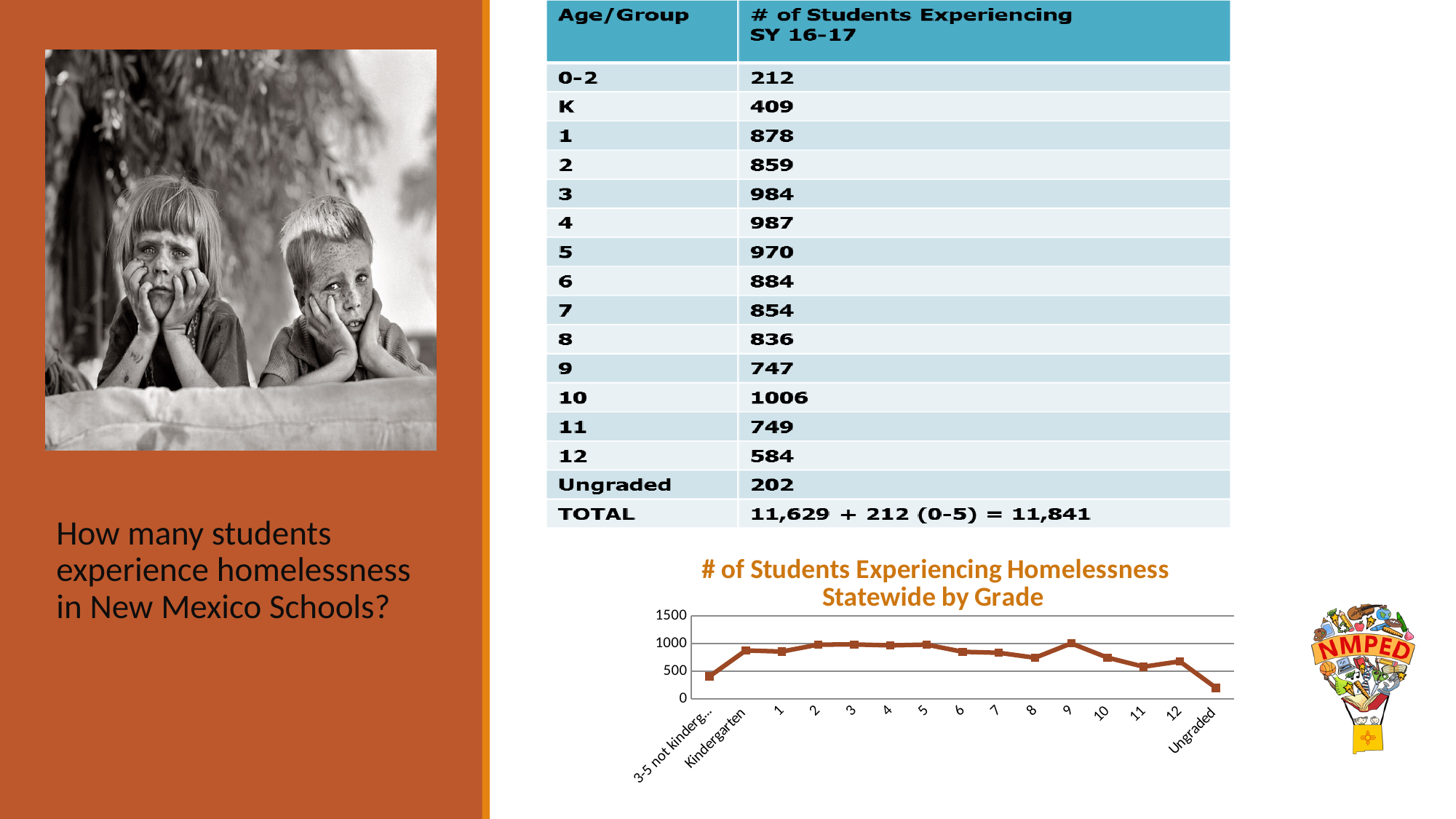
What kind of chart is shown on the slide? line chart In the chart, do the values rise or fall from grade 9 to Ungraded? fall How many data points are plotted along the x axis of the chart? 15 Is the value for grade 8 in the chart greater or less than 1000? less Is the value for grade 12 in the chart greater or less than 1000? less In the chart, which is larger: the value for Kindergarten or the value for Ungraded? Kindergarten Is the value for Ungraded in the chart greater or less than 500? less Which category has the lowest value in the chart? Ungraded In the chart, which is larger: the value for grade 5 or the value for grade 11? grade 5 What is the title of the chart on the slide? # of Students Experiencing Homelessness Statewide by Grade